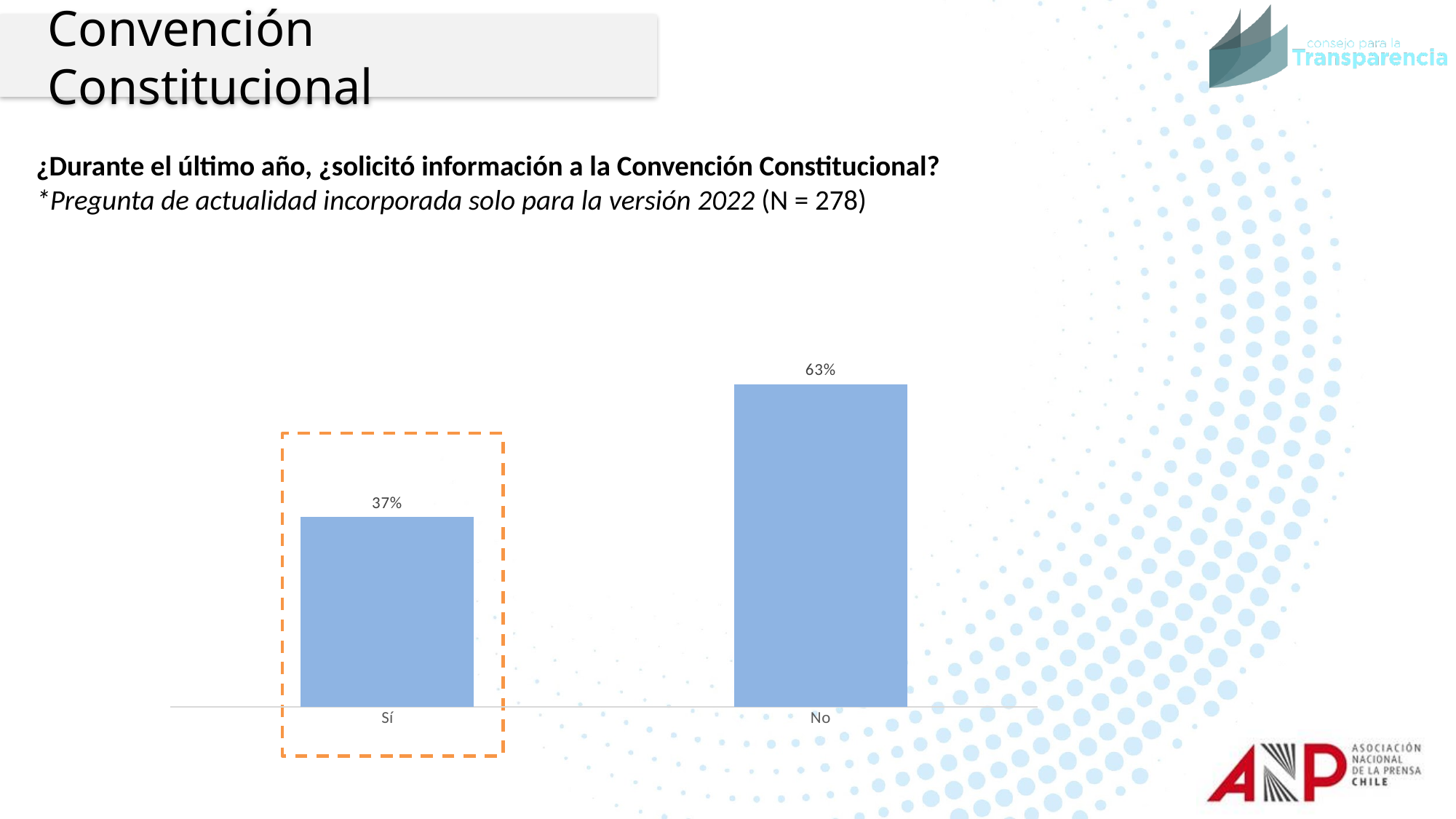
What is the sample size (N) stated for this question? 278 What percentage of respondents answered "Sí"? 37% Which is larger, the value for "Sí" or the value for "No"? No How many categories are shown in the chart? 2 Which category has the highest value? No Which category has the lowest value? Sí What percentage of respondents answered "No"? 63% What is the difference between the "No" and "Sí" values? 26% What kind of chart is shown on the slide? Bar chart Which bar is highlighted with a dashed orange box? Sí What is the total of the two bar values? 100%